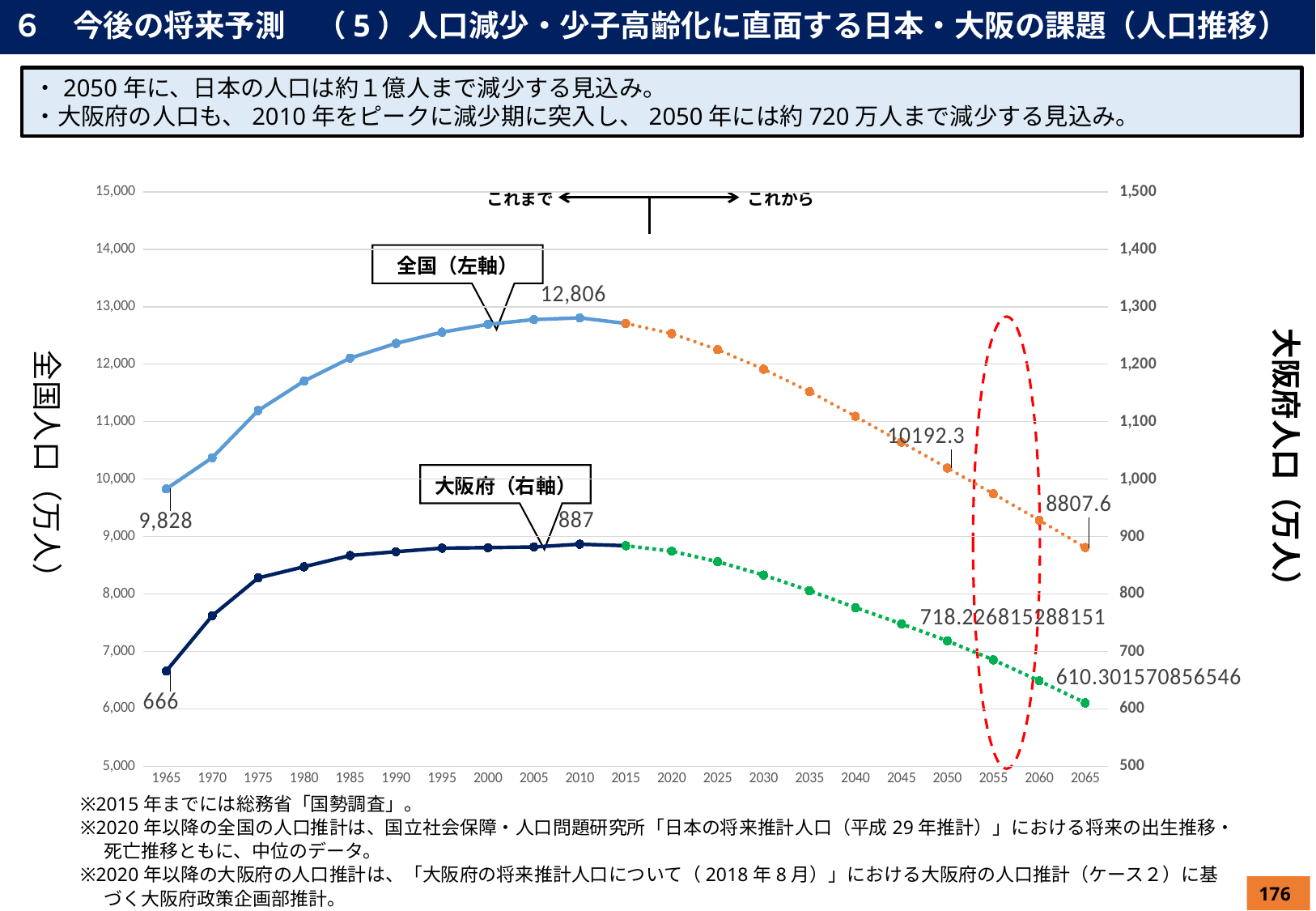
What is the Osaka Prefecture (大阪府) population value labelled for 2065? 610.301570856546 Which axis is used for the 大阪府 series, the left or the right? right Is the national population (全国) value for 2030 greater or less than 12,000? less Does the Osaka Prefecture (大阪府) line rise or fall from 2015 to 2065? fall What is the national population (全国) value labelled for 2010? 12,806 In which year does the national population (全国) line reach its highest labelled value? 2010 What is the national population (全国) value labelled for 2065? 8807.6 What is the national population (全国) value labelled for 1965? 9,828 What kind of chart is shown on the slide? Line chart What is the Osaka Prefecture (大阪府) population value labelled for 2010? 887 What is the Osaka Prefecture (大阪府) population value labelled for 1965? 666 How many years are shown on the x axis of the chart? 21